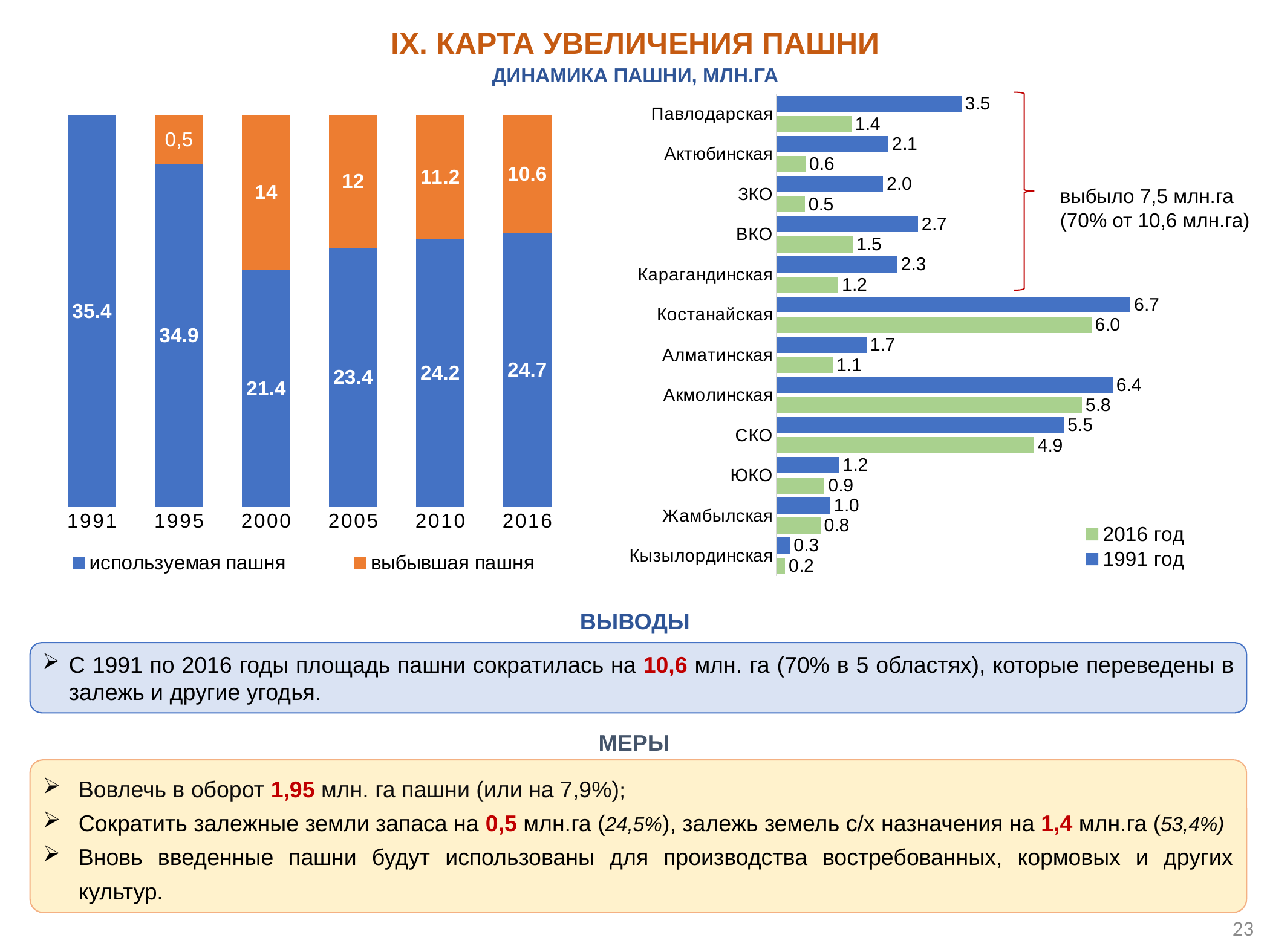
In the left stacked bar chart, what is the total of the 2010 bar (используемая пашня plus выбывшая пашня)? 35.4 In the right chart, which is larger: the 1991 год value for ВКО or the 1991 год value for Карагандинская? ВКО In the left stacked bar chart, how many series does the legend list? 2 In the left stacked bar chart, what is the value of используемая пашня for 2016? 24.7 In the right chart, what is the difference between the 1991 год and 2016 год values for Павлодарская? 2.1 In the right chart, what is the 2016 год value for Акмолинская? 5.8 In the left stacked bar chart, what is the value of выбывшая пашня for 2000? 14 What kind of chart is the chart on the right side of the slide? Bar chart In the right chart, what is the 1991 год value for Костанайская? 6.7 In the right chart, which region has the lowest 2016 год value? Кызылординская In the left stacked bar chart, which year has the highest value of выбывшая пашня? 2000 In the left stacked bar chart, how many years are shown on the x axis? 6